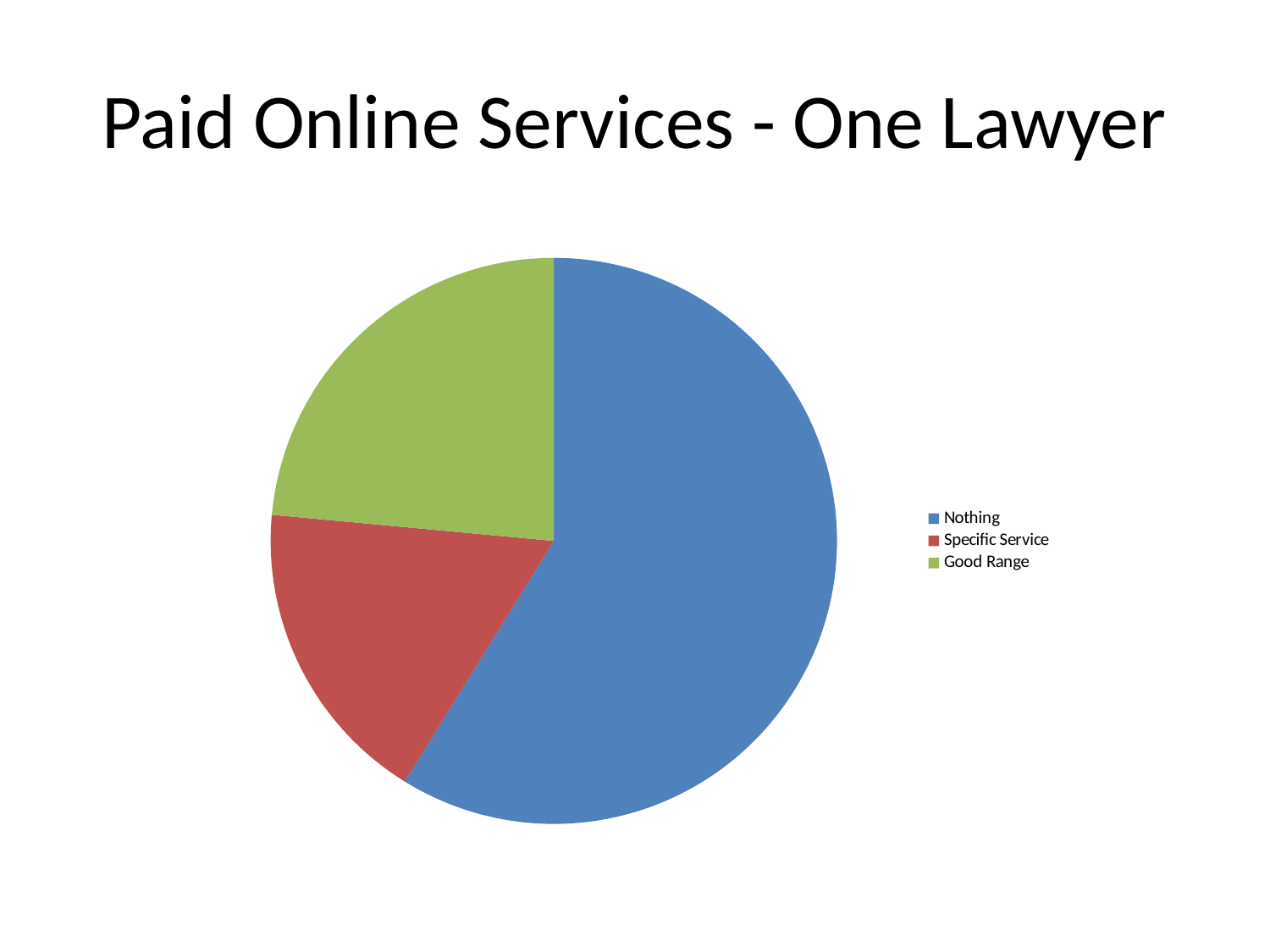
How many entries does the legend list? 3 What kind of chart is shown on the slide? pie chart Which category has the smallest slice of the pie? Specific Service How many slices does the pie chart have? 3 What is the title of the slide containing the pie chart? Paid Online Services - One Lawyer Which slice is larger, Good Range or Specific Service? Good Range Which slice is larger, Nothing or Good Range? Nothing What colour is the Specific Service slice? red Does the Nothing slice take up more or less than half of the pie? more Which category has the largest slice of the pie? Nothing